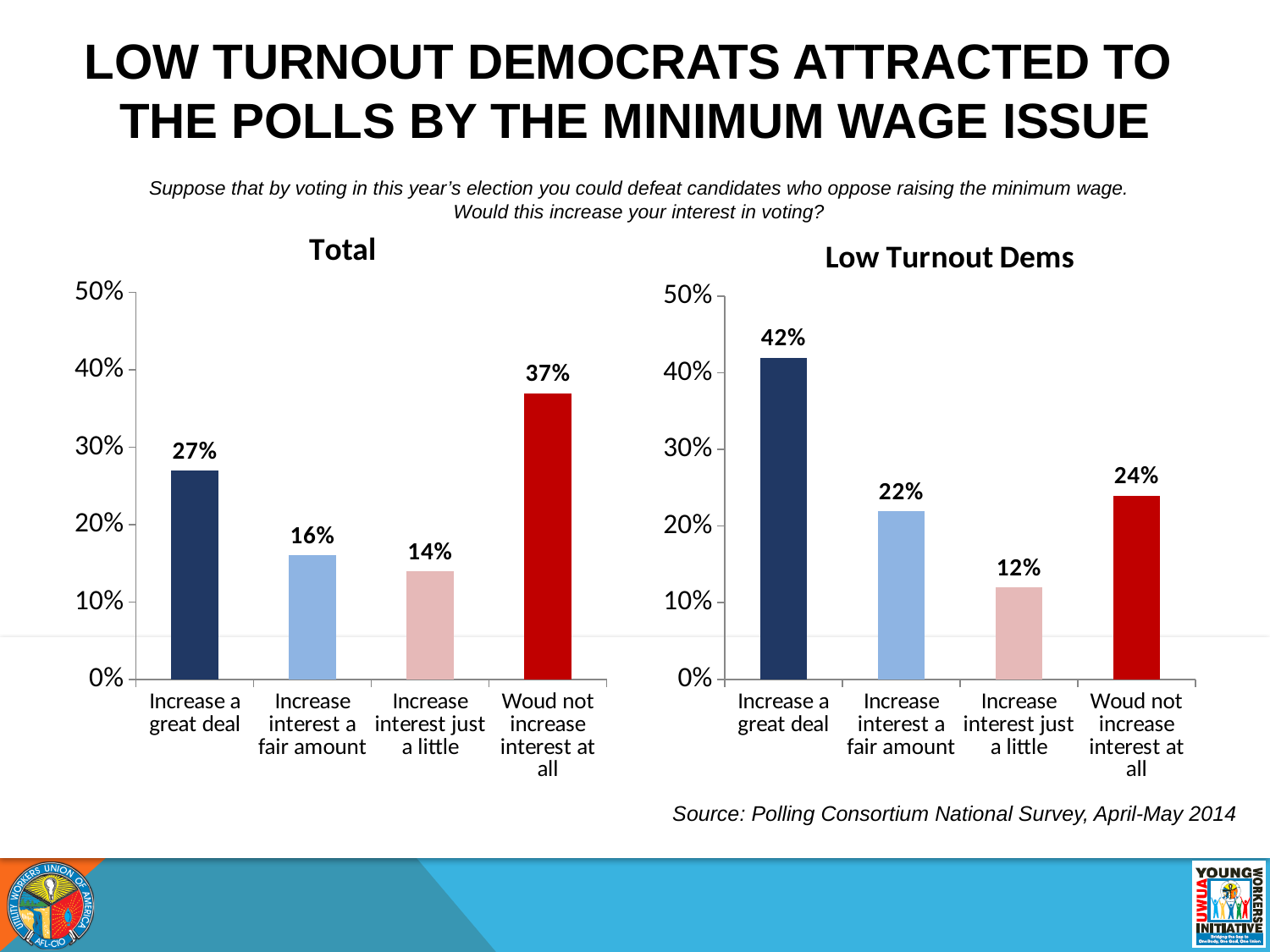
In the "Low Turnout Dems" chart, what is the difference between "Increase a great deal" and "Woud not increase interest at all"? 18% In the "Low Turnout Dems" chart, which category has the lowest value? Increase interest just a little What kind of chart is the "Total" chart? Bar chart In the "Low Turnout Dems" chart, what is the value for "Increase interest a fair amount"? 22% In the "Total" chart, is the value for "Woud not increase interest at all" greater or less than 30%? greater What is the title of the chart on the right side of the slide? Low Turnout Dems In the "Low Turnout Dems" chart, what is the value for "Woud not increase interest at all"? 24% In the "Total" chart, what is the value for "Increase a great deal"? 27% How many categories are shown in the "Low Turnout Dems" chart? 4 In the "Total" chart, what is the difference between "Increase interest a fair amount" and "Increase interest just a little"? 2% In the "Total" chart, which category has the highest value? Woud not increase interest at all Which is larger: "Increase a great deal" in the "Total" chart or "Increase a great deal" in the "Low Turnout Dems" chart? Low Turnout Dems